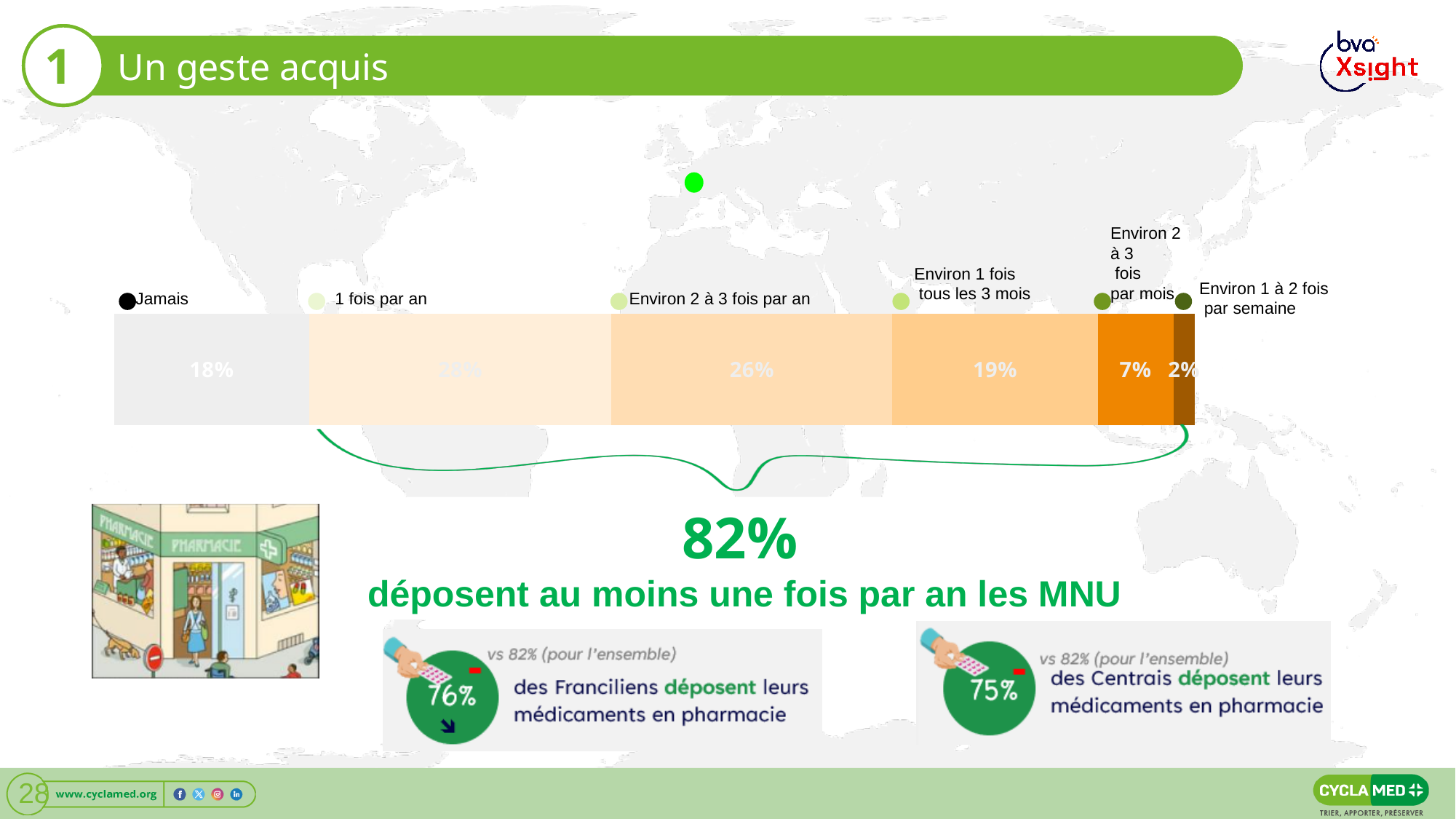
What is the combined total of all segments except "Jamais"? 82% What is the value shown for "1 fois par an"? 28% How many categories are shown in the stacked bar? 6 Which category has the highest value in the bar? 1 fois par an What is the difference between the values for "1 fois par an" and "Jamais"? 10% What is the value shown for "Environ 1 à 2 fois par semaine"? 2% Which category has the lowest value in the bar? Environ 1 à 2 fois par semaine What percentage of respondents answered "Jamais"? 18% What is the value shown for "Environ 1 fois tous les 3 mois"? 19% What is the value shown for "Environ 2 à 3 fois par an"? 26% Which is larger, the value for "Environ 2 à 3 fois par an" or the value for "Environ 1 fois tous les 3 mois"? Environ 2 à 3 fois par an What kind of chart is shown on the slide? Stacked bar chart